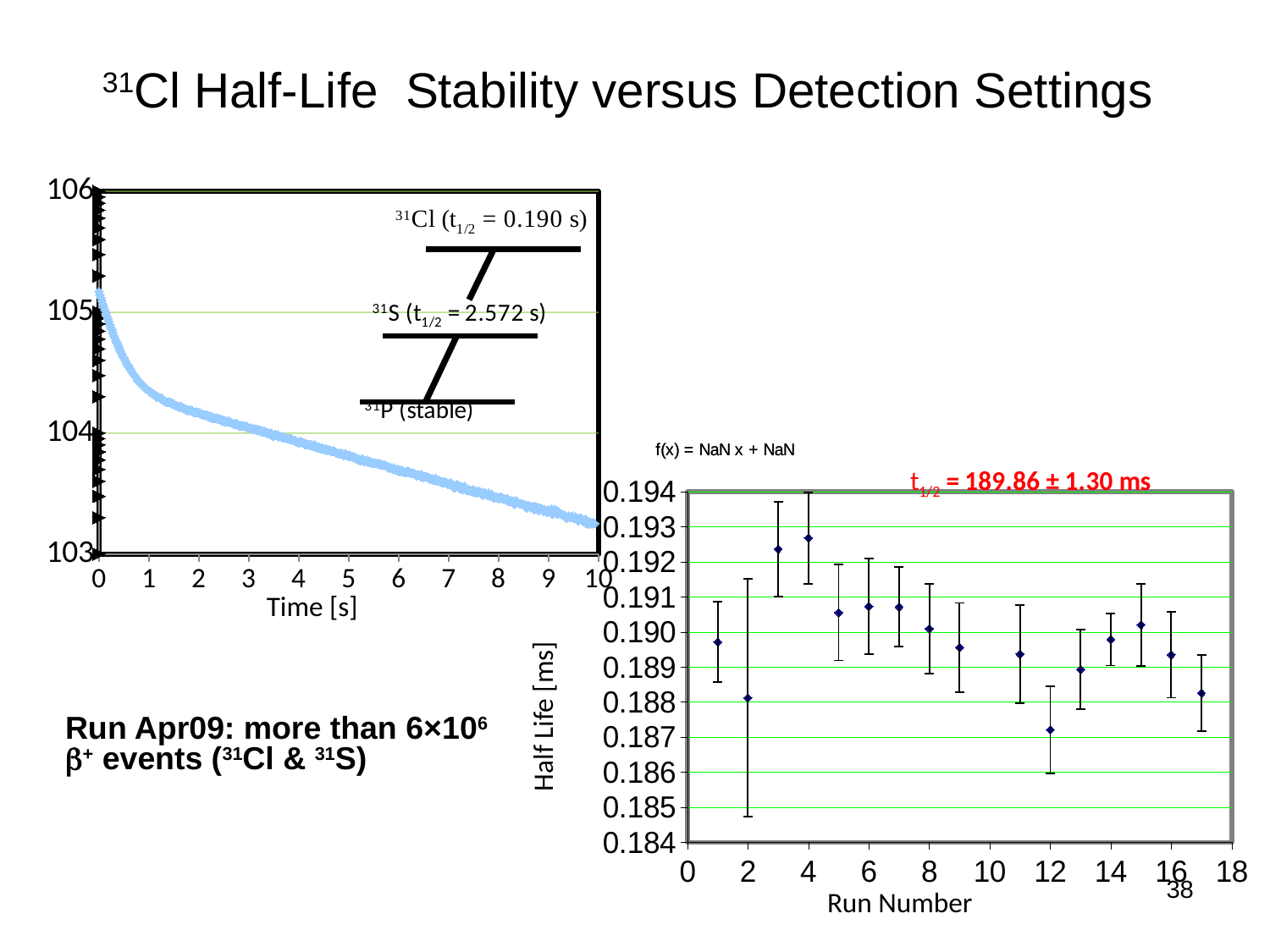
What kind of chart is the chart on the right (Half Life vs Run Number)? scatter chart with error bars In the chart on the left, do the values rise or fall as Time [s] increases? fall In the chart on the right, which has the larger Half Life: Run Number 4 or Run Number 12? Run Number 4 In the chart on the right, is the Half Life for Run Number 2 greater or less than 0.189? less In the chart on the left, is the value at Time 5 s greater or less than 104? less In the chart on the right, is the Half Life for Run Number 12 greater or less than 0.189? less In the chart on the right, which Run Number has the lowest Half Life? 12 What half-life value is printed in red above the chart on the right? t1/2 = 189.86 ± 1.30 ms What kind of chart is the chart on the left (Time [s] on the x axis)? line chart What is the y-axis label of the chart on the right? Half Life [ms]